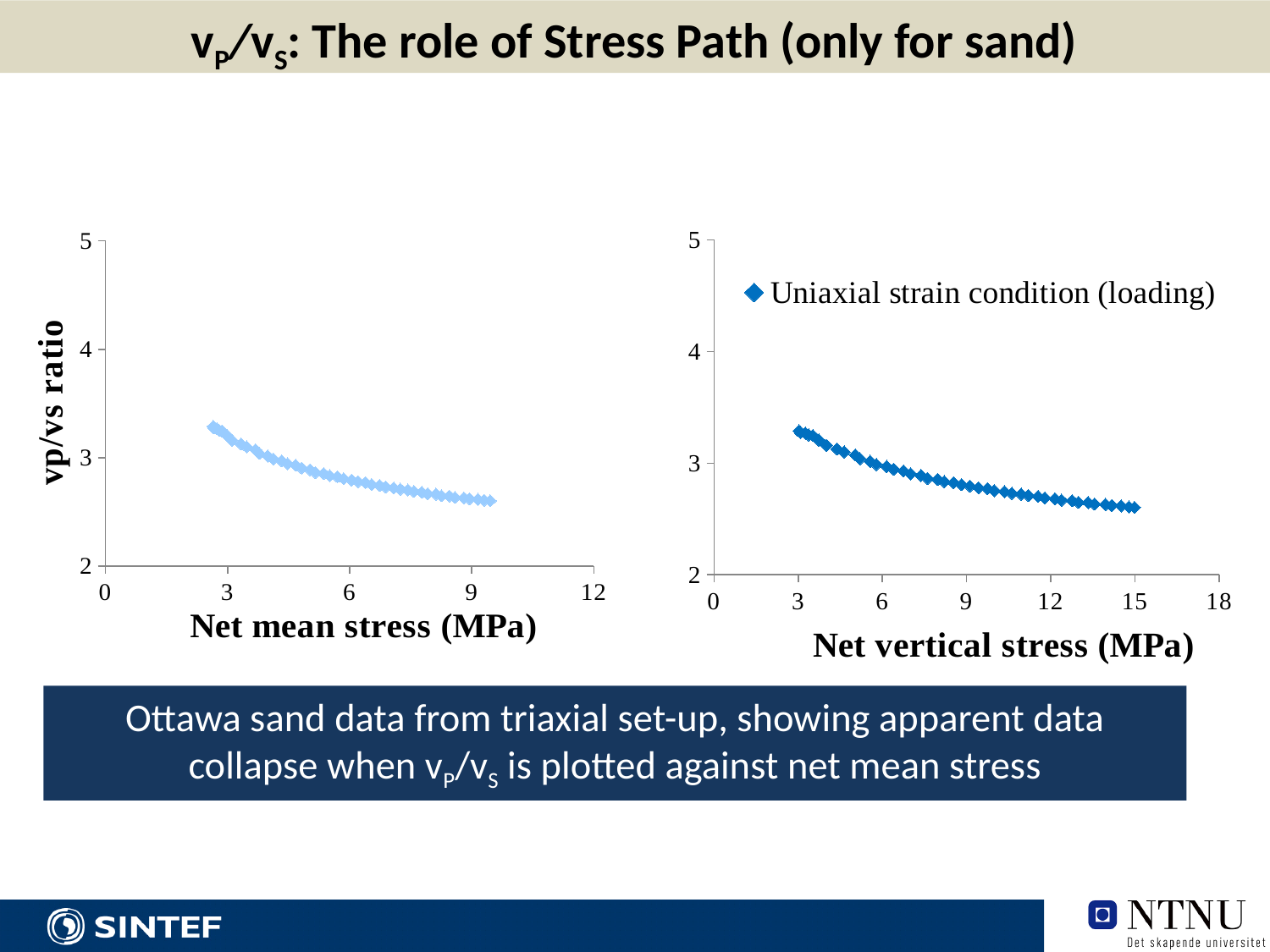
In the left chart (Net mean stress), do the vp/vs ratio values rise or fall as net mean stress increases? fall What kind of chart is the left chart, with x-axis 'Net mean stress (MPa)'? scatter chart What is the legend entry shown in the right chart (Net vertical stress)? Uniaxial strain condition (loading) In the right chart (Net vertical stress), do the vp/vs ratio values rise or fall as net vertical stress increases? fall What is the y-axis label of the left chart? vp/vs ratio How many series does the legend of the right chart (Net vertical stress) list? 1 In the left chart (Net mean stress), is the vp/vs ratio at a net mean stress of 9 MPa greater or less than 3? less In the right chart (Net vertical stress), is the vp/vs ratio at a net vertical stress of 15 MPa greater or less than 3? less What kind of chart is the right chart, with x-axis 'Net vertical stress (MPa)'? scatter chart In the left chart (Net mean stress), is the vp/vs ratio at a net mean stress of 3 MPa greater or less than 3? greater